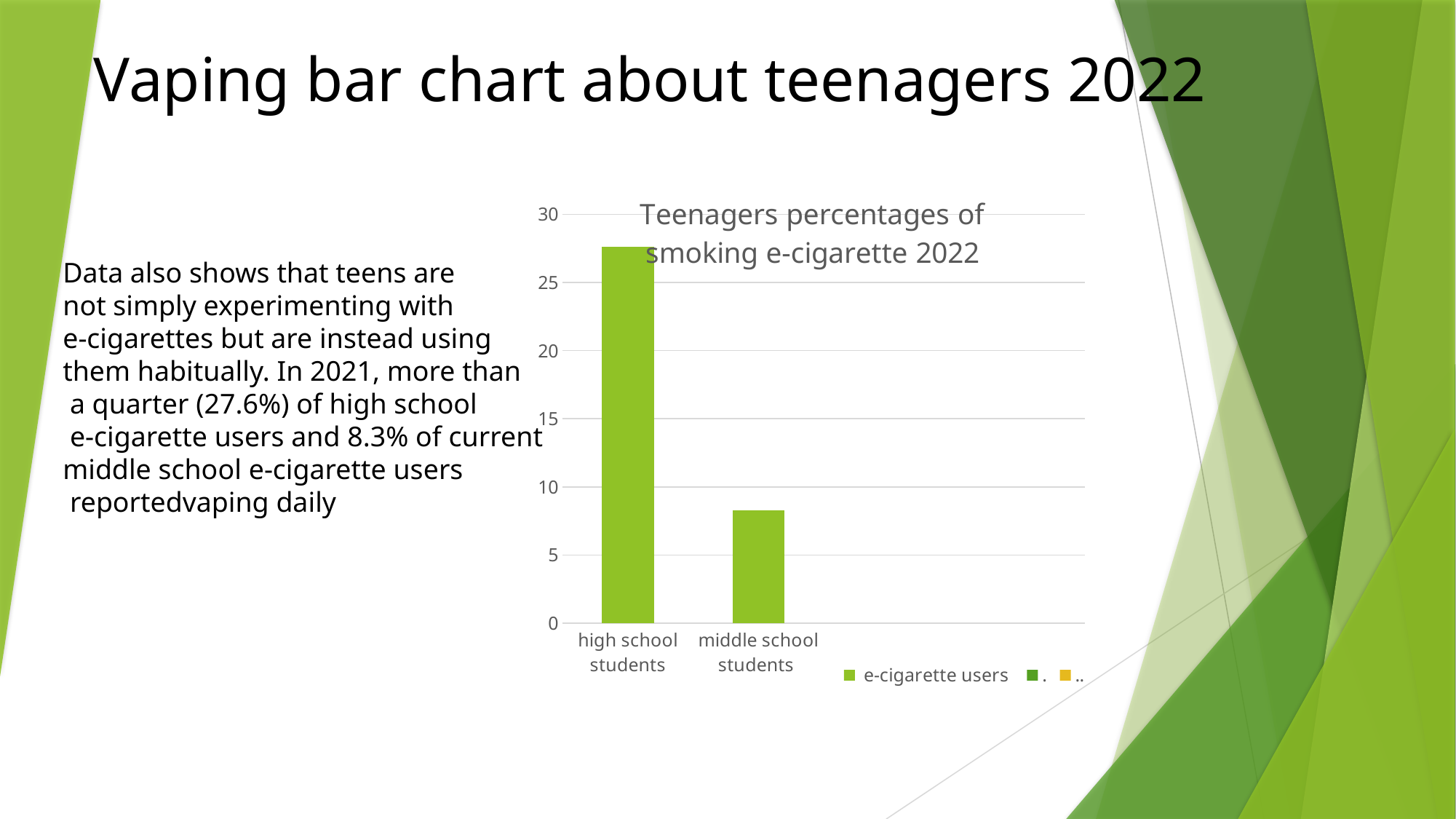
Is the value for high school students greater or less than 30? less Is the value for middle school students greater or less than 5? greater What kind of chart is shown on the slide? bar chart What is the first series name listed in the chart legend? e-cigarette users Which category has the lowest bar in the chart? middle school students Is the value for high school students greater or less than 25? greater What is the title of the chart? Teenagers percentages of smoking e-cigarette 2022 How many categories are plotted on the x axis of the chart? 2 What is the highest value shown on the chart's vertical axis? 30 Which category has the highest bar in the chart? high school students Which is larger, the value for high school students or the value for middle school students? high school students